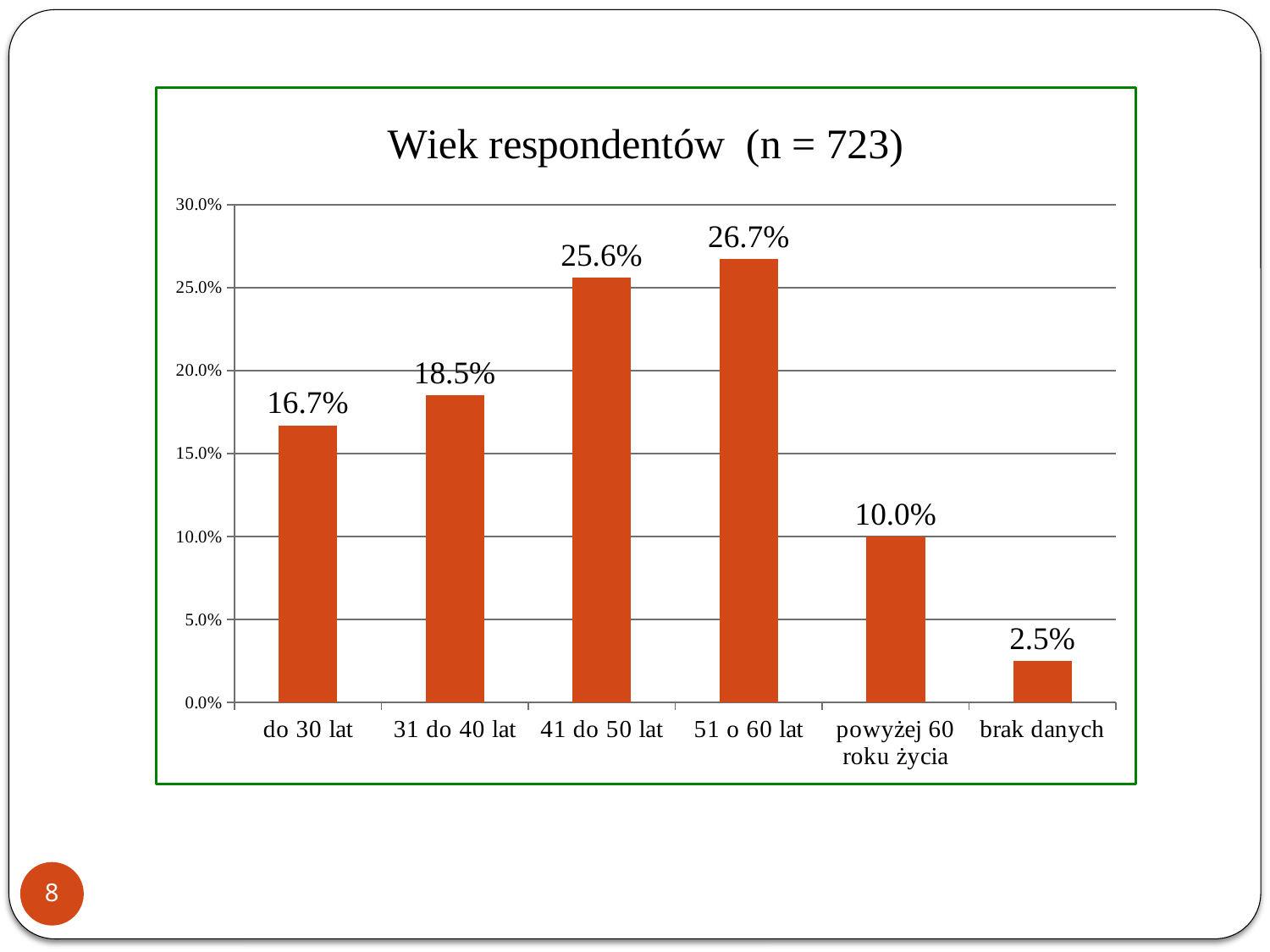
Which category has the highest value? 51 o 60 lat Which is larger, the value for 'do 30 lat' or the value for 'powyżej 60 roku życia'? do 30 lat How many categories are shown on the x axis? 6 Which category has the lowest value? brak danych What is the difference between the values for '51 o 60 lat' and '41 do 50 lat'? 1.1% Is the value for '51 o 60 lat' greater or less than 25.0%? greater What is the value for the 'powyżej 60 roku życia' category? 10.0% What kind of chart is shown on the slide? bar chart What is the value for the 'brak danych' category? 2.5% What is the title of the chart? Wiek respondentów (n = 723) What is the difference between the values for '31 do 40 lat' and 'do 30 lat'? 1.8% What is the value for the '41 do 50 lat' category? 25.6%